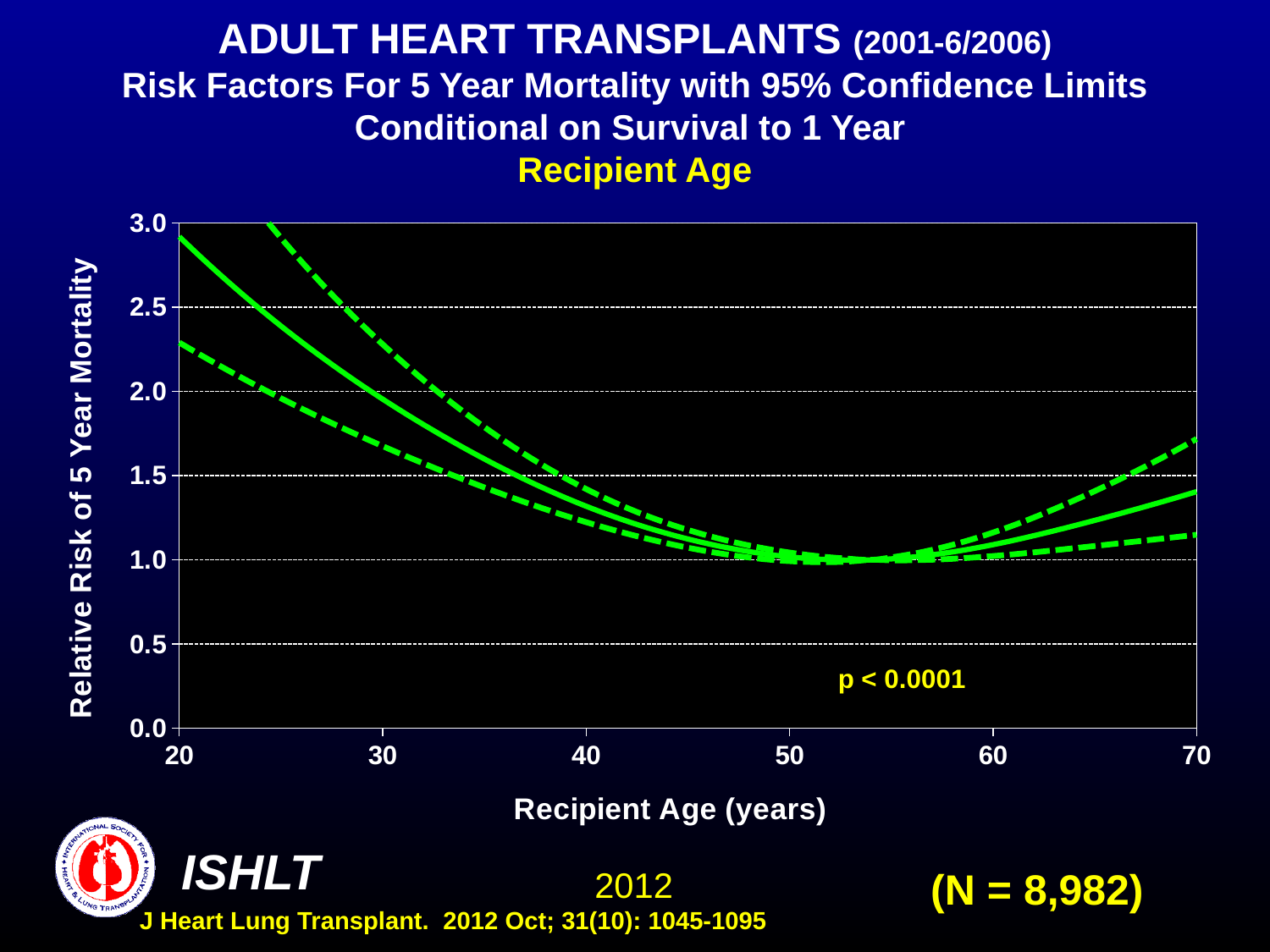
Is the relative risk of 5 year mortality (solid line) at recipient age 40 greater or less than 1.0? greater What kind of chart is shown on the slide? line chart Is the relative risk of 5 year mortality (solid line) at recipient age 20 greater or less than 2.5? greater Which is larger, the relative risk of 5 year mortality at recipient age 30 or at recipient age 50? age 30 What is the label of the x axis of the chart? Recipient Age (years) Is the relative risk of 5 year mortality (solid line) at recipient age 30 greater or less than 1.5? greater Does the relative risk of 5 year mortality rise or fall as recipient age increases from 55 to 70? rise What p-value is printed on the chart? p < 0.0001 Does the relative risk of 5 year mortality rise or fall as recipient age increases from 20 to 50? fall Which is larger, the relative risk of 5 year mortality at recipient age 20 or at recipient age 70? age 20